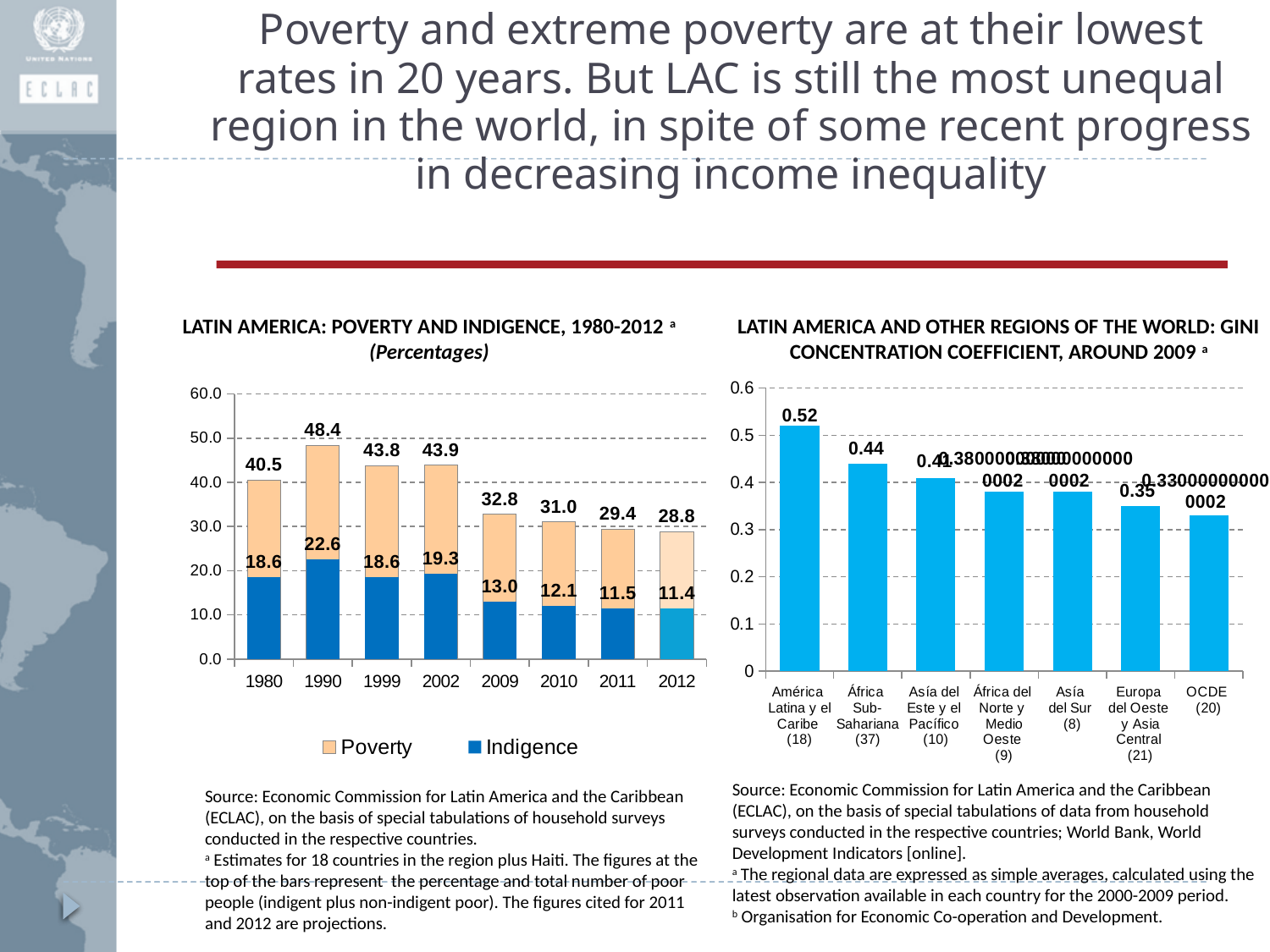
How many series does the legend of the chart 'Latin America: Poverty and Indigence, 1980-2012' list? 2 In the chart 'Latin America: Poverty and Indigence, 1980-2012', what is the difference between the total printed for 1980 and the total printed for 2012? 11.7 In the chart 'Latin America: Poverty and Indigence, 1980-2012', which year has the highest total at the top of its bar? 1990 What kind of chart is 'Latin America: Poverty and Indigence, 1980-2012'? Stacked bar chart In the Gini concentration coefficient chart on the right, is the value for Asia del Sur (8) greater or less than 0.4? less How many years are shown on the x axis of the chart 'Latin America: Poverty and Indigence, 1980-2012'? 8 In the Gini concentration coefficient chart on the right, do the values rise or fall from left to right along the x axis? fall In the Gini concentration coefficient chart on the right, which region has the lowest value? OCDE (20) In the chart 'Latin America: Poverty and Indigence, 1980-2012', what total value is printed at the top of the 1990 bar? 48.4 In the Gini concentration coefficient chart on the right, what is the value for América Latina y el Caribe (18)? 0.52 In the chart 'Latin America: Poverty and Indigence, 1980-2012', which year has the lowest Indigence value? 2012 In the chart 'Latin America: Poverty and Indigence, 1980-2012', what is the Indigence value for 1990? 22.6